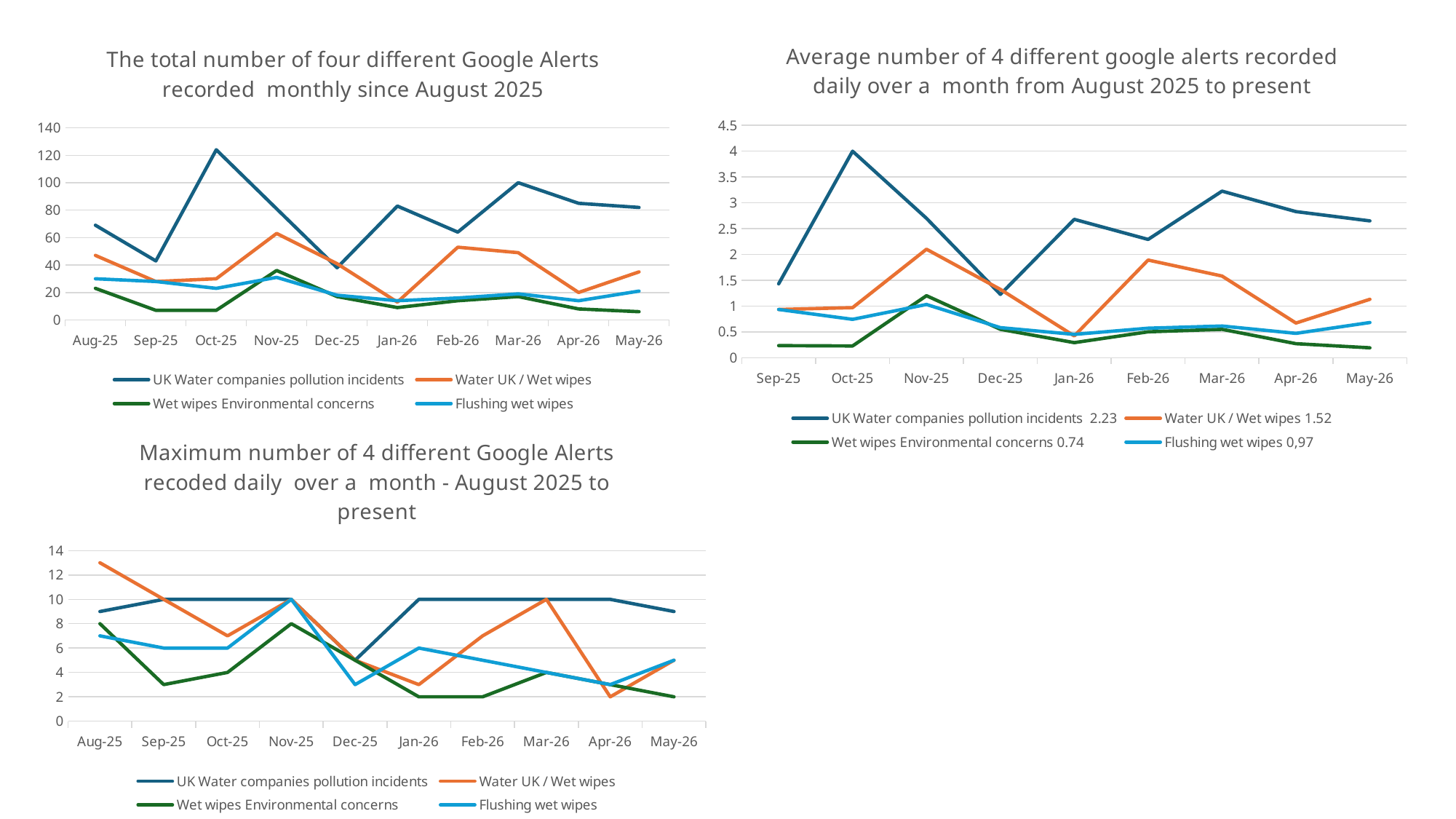
In the chart 'Maximum number of 4 different Google Alerts recoded daily over a month - August 2025 to present', what is the value for Wet wipes Environmental concerns in Nov-25? 8 In the chart 'The total number of four different Google Alerts recorded monthly since August 2025', in which month is the UK Water companies pollution incidents series highest? Oct-25 In the chart 'The total number of four different Google Alerts recorded monthly since August 2025', is the value for UK Water companies pollution incidents in Oct-25 greater or less than 100? greater In the chart 'Maximum number of 4 different Google Alerts recoded daily over a month - August 2025 to present', what is the value for Water UK / Wet wipes in Mar-26? 10 In the chart 'Average number of 4 different google alerts recorded daily over a month from August 2025 to present', how many months are shown on the x axis? 9 In the chart 'The total number of four different Google Alerts recorded monthly since August 2025', which is larger in Oct-25: UK Water companies pollution incidents or Water UK / Wet wipes? UK Water companies pollution incidents In the chart 'The total number of four different Google Alerts recorded monthly since August 2025', how many months are shown on the x axis? 10 In the chart 'The total number of four different Google Alerts recorded monthly since August 2025', how many series does the legend list? 4 What kind of chart is 'The total number of four different Google Alerts recorded monthly since August 2025'? line chart In the chart 'Average number of 4 different google alerts recorded daily over a month from August 2025 to present', what is the value for UK Water companies pollution incidents in Oct-25? 4 In the chart 'Average number of 4 different google alerts recorded daily over a month from August 2025 to present', what number appears after 'Water UK / Wet wipes' in the legend? 1.52 In the chart 'Maximum number of 4 different Google Alerts recoded daily over a month - August 2025 to present', in which month is the Water UK / Wet wipes series lowest? Apr-26